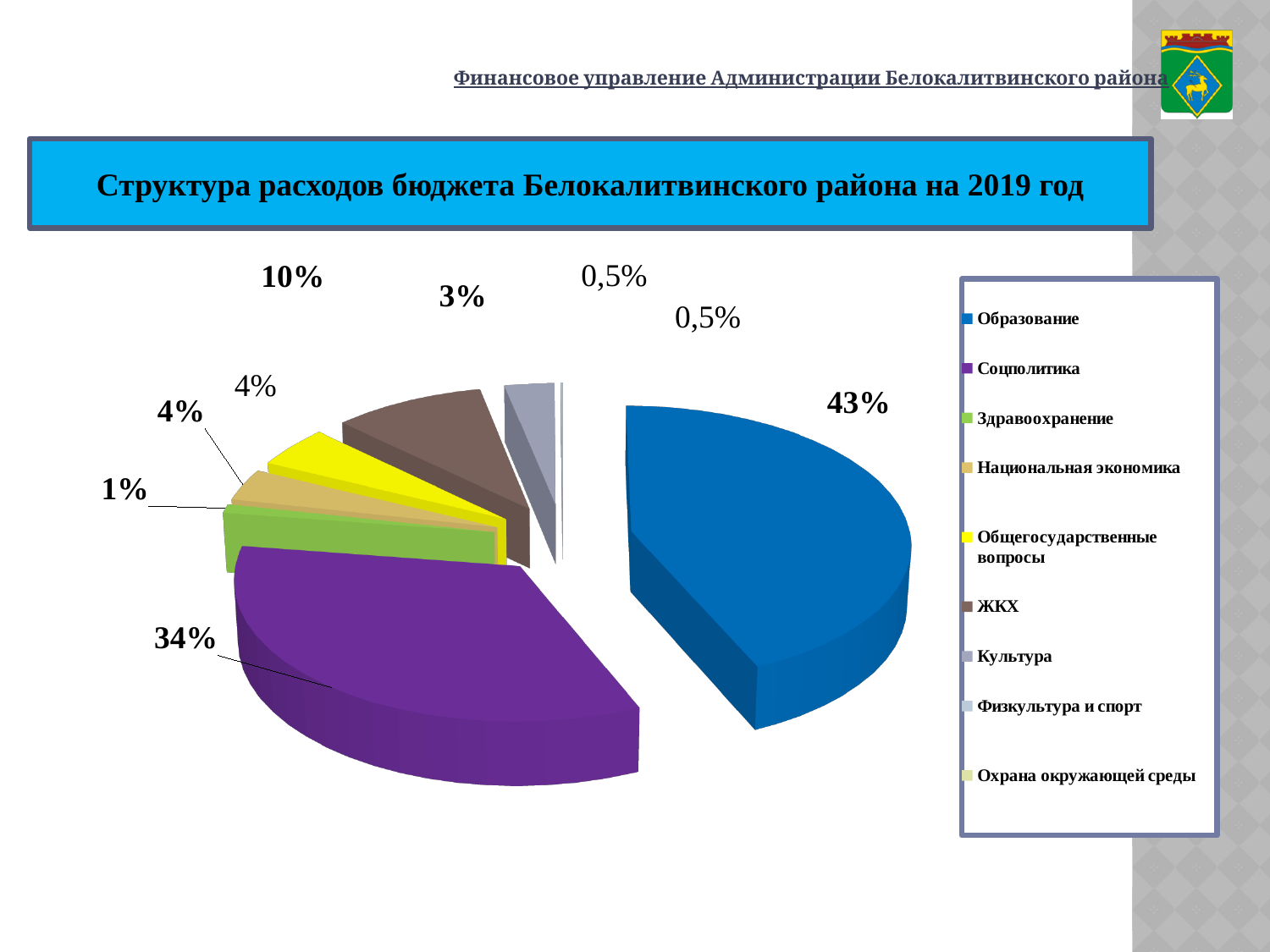
How many categories does the legend list? 9 What is the title of the chart on the slide? Структура расходов бюджета Белокалитвинского района на 2019 год What is the value shown for Культура? 3% Which is larger, the share for Соцполитика or the share for ЖКХ? Соцполитика What is the value shown for Соцполитика? 34% What is the difference in percentage points between Образование and Соцполитика? 9 What kind of chart is shown on the slide? pie chart What share of the pie does Образование have? 43% What colour is the slice for Образование? blue What is the value shown for Физкультура и спорт? 0,5% Which category has the largest share of the pie? Образование What is the value shown for ЖКХ? 10%